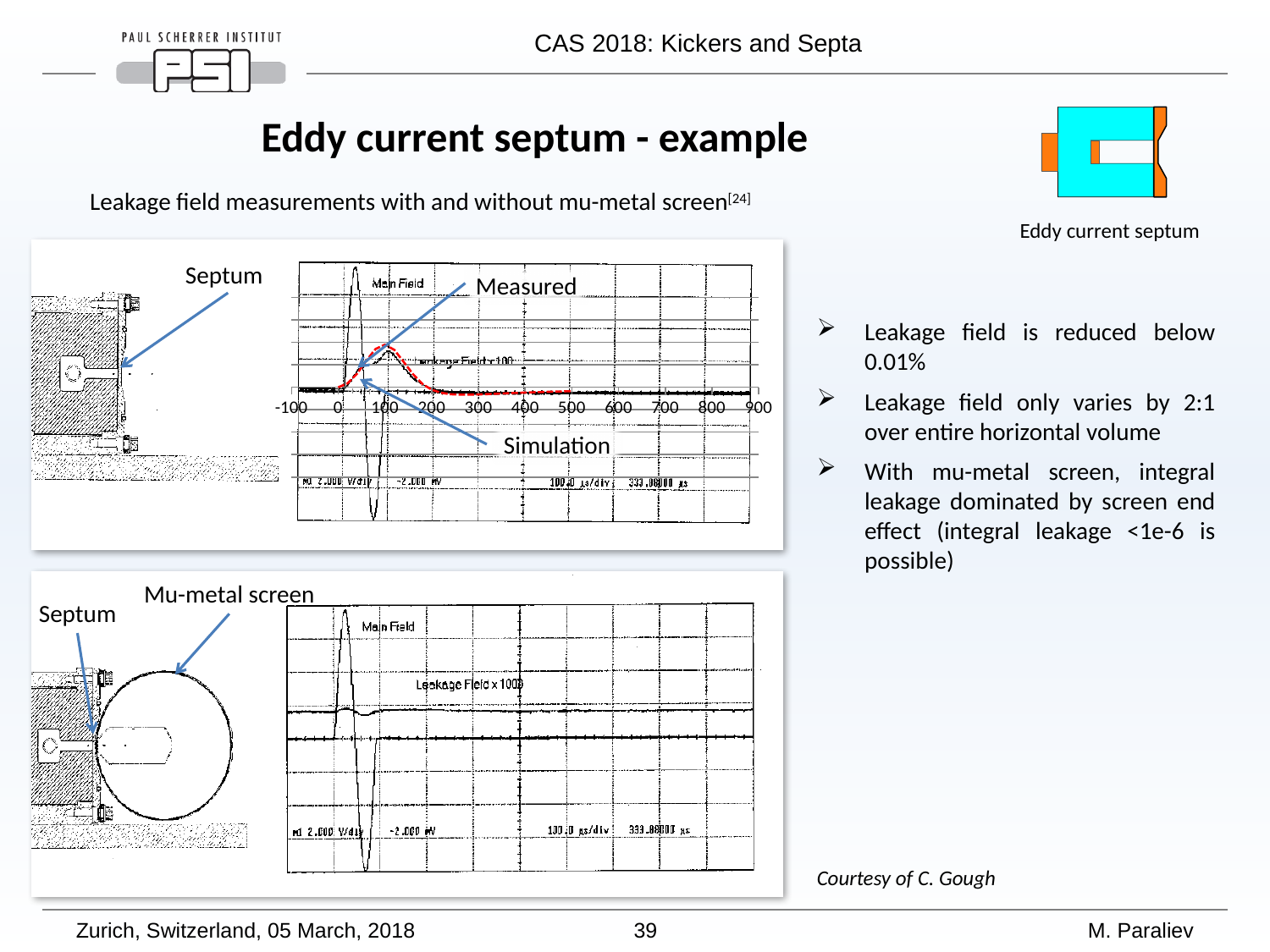
What kind of chart is shown in the top panel (the one without the mu-metal screen)? line chart (oscilloscope trace) In the top chart, is the peak of the Leakage Field x 100 trace located at a horizontal-axis value greater or less than 300? less In the top chart, which trace has the larger peak amplitude: the Main Field or the Leakage Field x 100? Main Field In the bottom chart (with mu-metal screen), by what factor is the leakage field trace scaled, according to its label? x 1000 In the top chart, what is the highest value labelled on the horizontal axis? 900 In the top chart, what are the two traces annotated with arrows called? Measured and Simulation In the top chart, by what factor is the leakage field trace scaled, according to its label? x 100 How many measurement charts (oscilloscope traces) are shown on the slide? 2 In the top chart, what is the lowest value labelled on the horizontal axis? -100